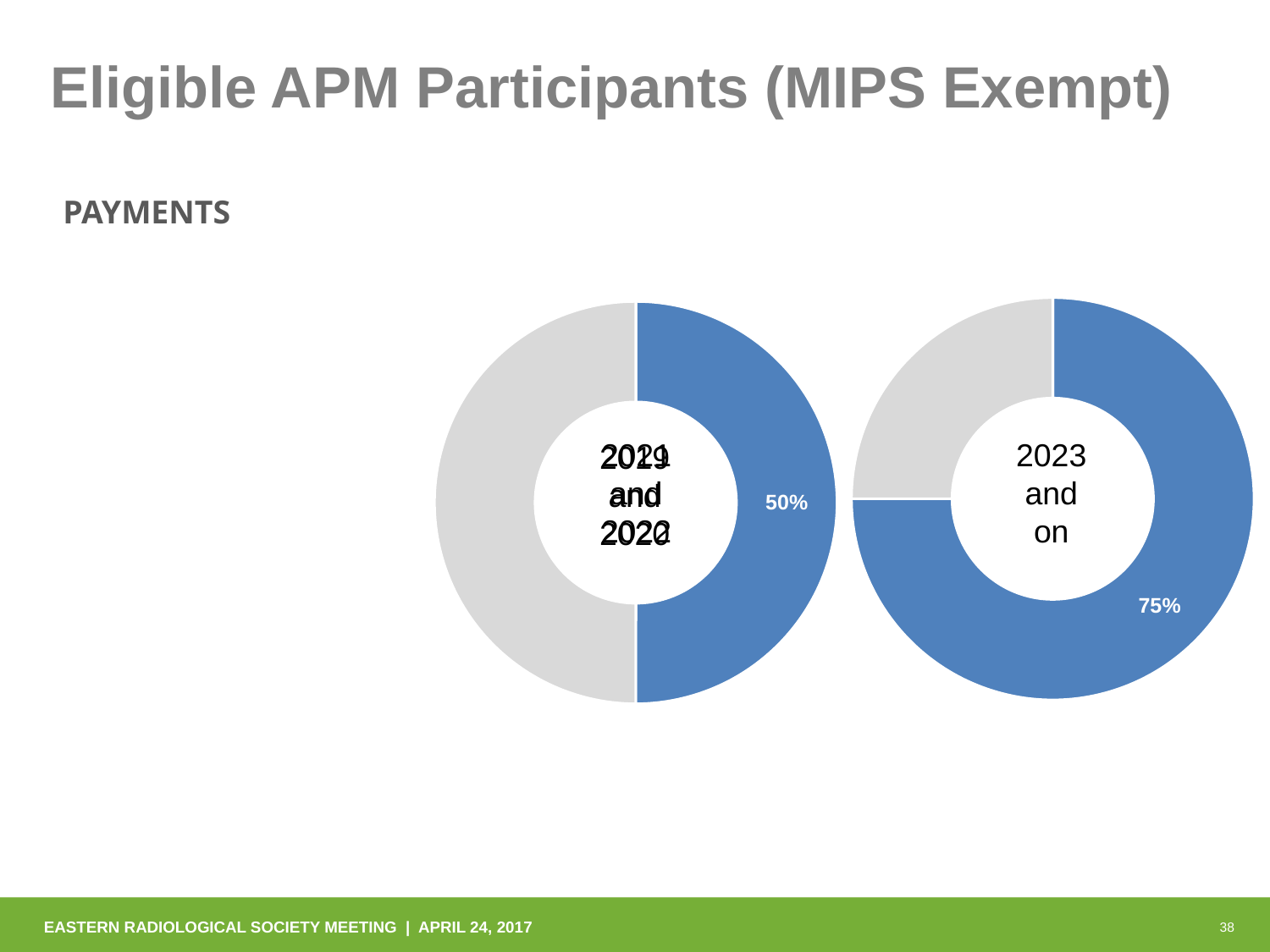
Which donut chart shows the larger blue percentage, the left one or the right one ('2023 and on')? The right one (2023 and on) What kind of charts are shown on the slide? Donut (pie) charts What colour is the segment labelled 75% in the right donut chart? Blue In the left donut chart, what percentage is shown for the blue segment? 50% In the right donut chart labelled '2023 and on', what percentage is shown for the blue segment? 75% What is the difference between the percentage in the right donut chart ('2023 and on') and the percentage in the left donut chart? 25 percentage points What is the centre label of the right donut chart? 2023 and on What is the heading printed above the charts on the slide? PAYMENTS How many donut charts are on the slide? 2 In the right donut chart ('2023 and on'), is the blue segment greater or less than half of the ring? greater